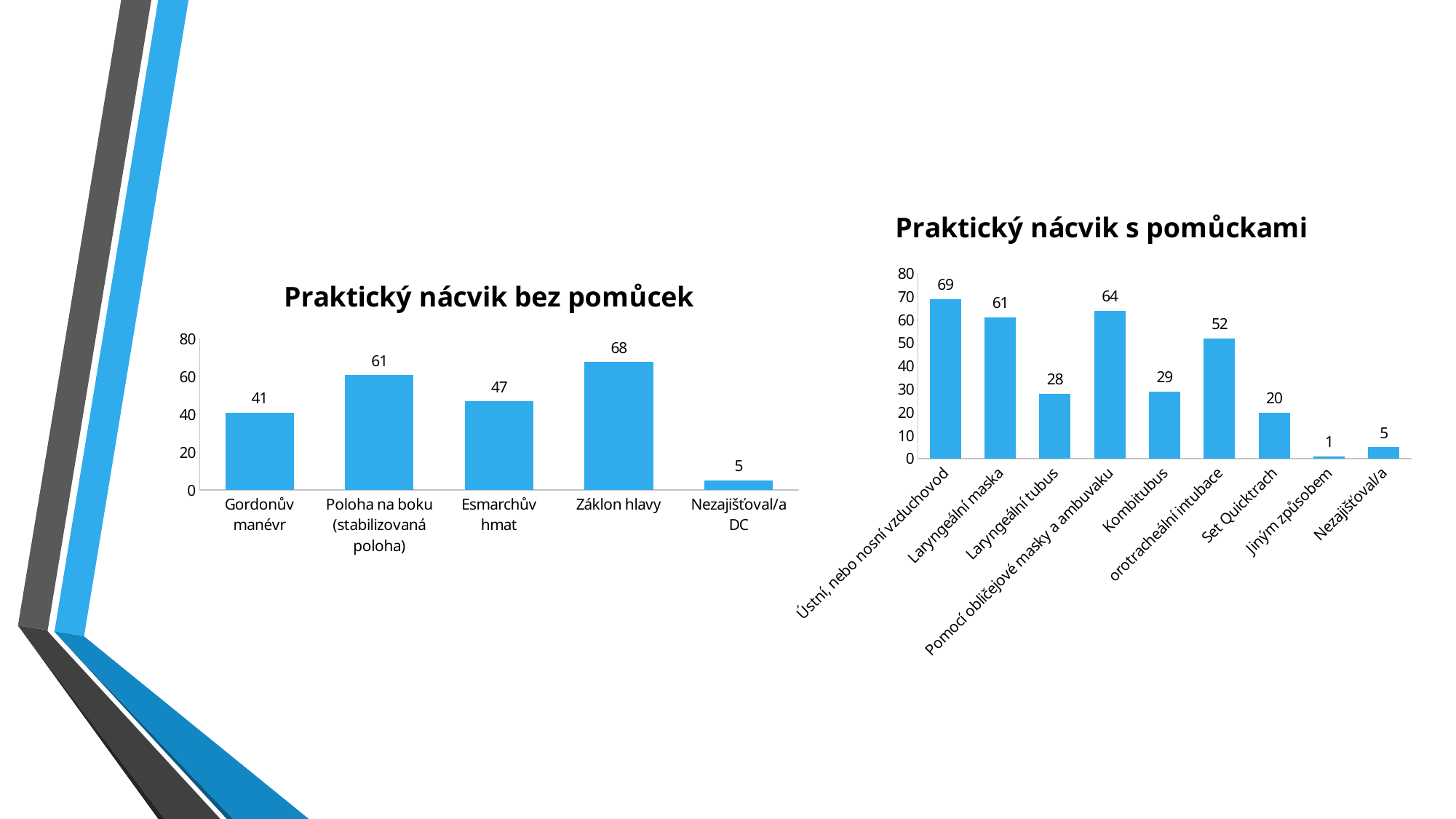
In the chart titled 'Praktický nácvik s pomůckami', which category has the highest value? Ústní, nebo nosní vzduchovod In the chart titled 'Praktický nácvik s pomůckami', which category has the lowest value? Jiným způsobem In the chart titled 'Praktický nácvik bez pomůcek', which is larger: Esmarchův hmat or Gordonův manévr? Esmarchův hmat In the chart titled 'Praktický nácvik bez pomůcek', which category has the lowest value? Nezajišťoval/a DC In the chart titled 'Praktický nácvik s pomůckami', what is the difference between orotracheální intubace and Set Quicktrach? 32 In the chart titled 'Praktický nácvik bez pomůcek', what is the value for Záklon hlavy? 68 What type of chart is 'Praktický nácvik s pomůckami'? Bar chart In the chart titled 'Praktický nácvik s pomůckami', how many categories are shown? 9 In the chart titled 'Praktický nácvik bez pomůcek', what is the difference between Poloha na boku (stabilizovaná poloha) and Gordonův manévr? 20 In the chart titled 'Praktický nácvik s pomůckami', what is the value for Kombitubus? 29 In the chart titled 'Praktický nácvik bez pomůcek', how many categories are shown? 5 In the chart titled 'Praktický nácvik s pomůckami', what is the value for Laryngeální tubus? 28